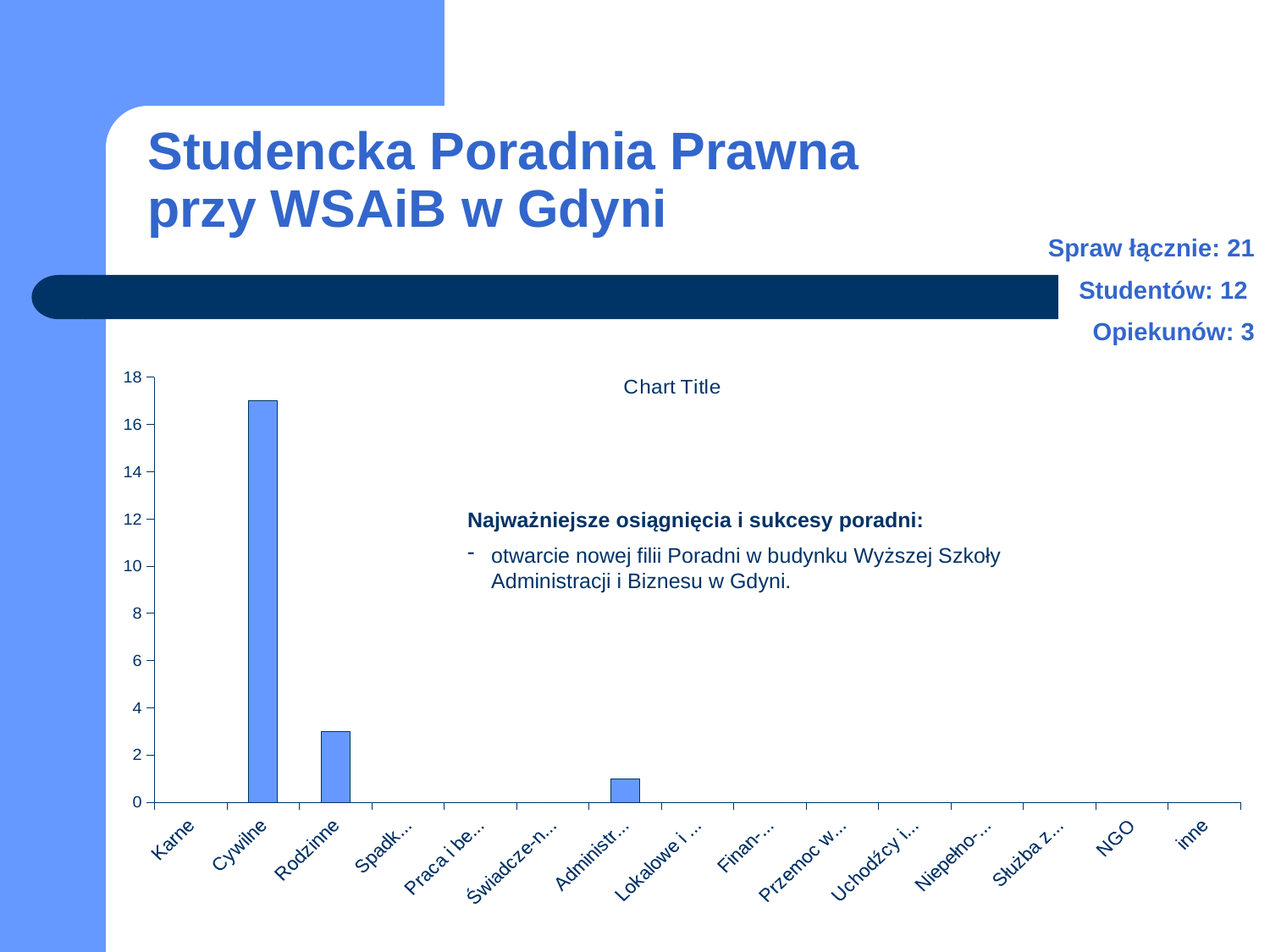
Which category has the highest value in the chart? Cywilne Is the value for Rodzinne greater or less than 2? greater What is the highest value shown on the y axis of the chart? 18 Is the value for Rodzinne greater or less than 4? less What kind of chart is shown on the slide? bar chart Is the value for Administr... greater or less than 2? less Which is larger, the value for Cywilne or the value for Rodzinne? Cywilne How many categories are shown on the x axis of the chart? 15 What is the title shown on the chart? Chart Title Which is larger, the value for Rodzinne or the value for Administr...? Rodzinne